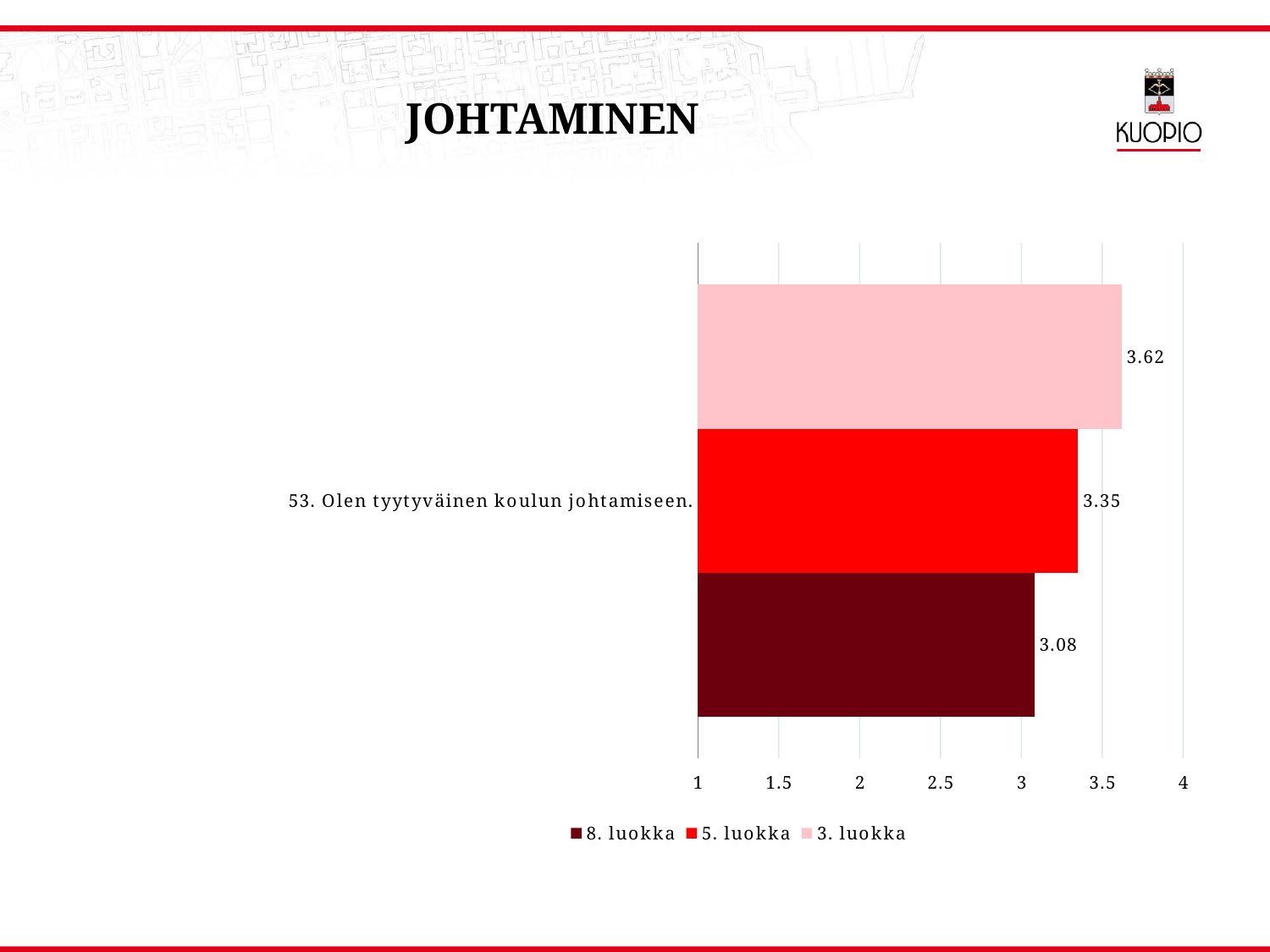
Which is larger, the value for 5. luokka or the value for 8. luokka? 5. luokka What colour is the bar for 8. luokka? Dark red What kind of chart is shown on the slide? Bar chart What is the difference between the values for 5. luokka and 8. luokka? 0.27 What is the value for 3. luokka for the statement "53. Olen tyytyväinen koulun johtamiseen."? 3.62 What is the difference between the values for 3. luokka and 8. luokka? 0.54 What is the value for 8. luokka for the statement "53. Olen tyytyväinen koulun johtamiseen."? 3.08 Which series has the lowest value in the chart? 8. luokka Which series has the highest value in the chart? 3. luokka Is the value for 3. luokka greater or less than 3.5? greater What is the value for 5. luokka for the statement "53. Olen tyytyväinen koulun johtamiseen."? 3.35 How many series does the legend list? 3